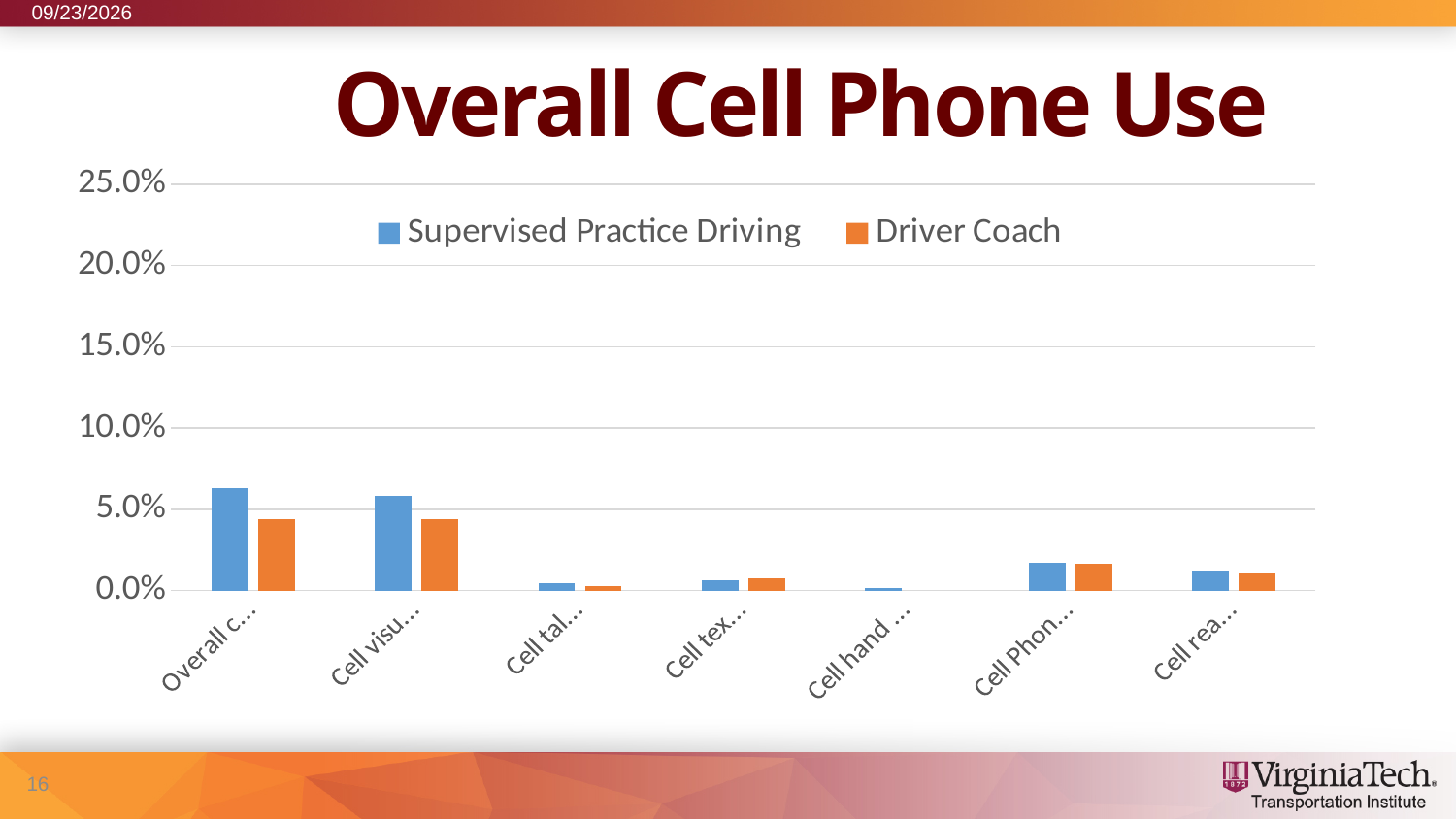
Which category has the lowest Supervised Practice Driving value? The fifth category ("Cell hand ...") What is the title of the chart? Overall Cell Phone Use Is any value on the chart greater than 10.0%? No How many categories are plotted along the x axis? 7 For the first category ("Overall c..."), which series has the larger value, Supervised Practice Driving or Driver Coach? Supervised Practice Driving How many series does the chart's legend list? 2 What kind of chart is shown on the slide? Bar chart Is the Supervised Practice Driving value for the first category ("Overall c...") greater or less than 5.0%? greater For the second category ("Cell visu..."), which series has the larger value, Supervised Practice Driving or Driver Coach? Supervised Practice Driving What are the two series named in the legend? Supervised Practice Driving and Driver Coach Is the Driver Coach value for the first category ("Overall c...") greater or less than 5.0%? less